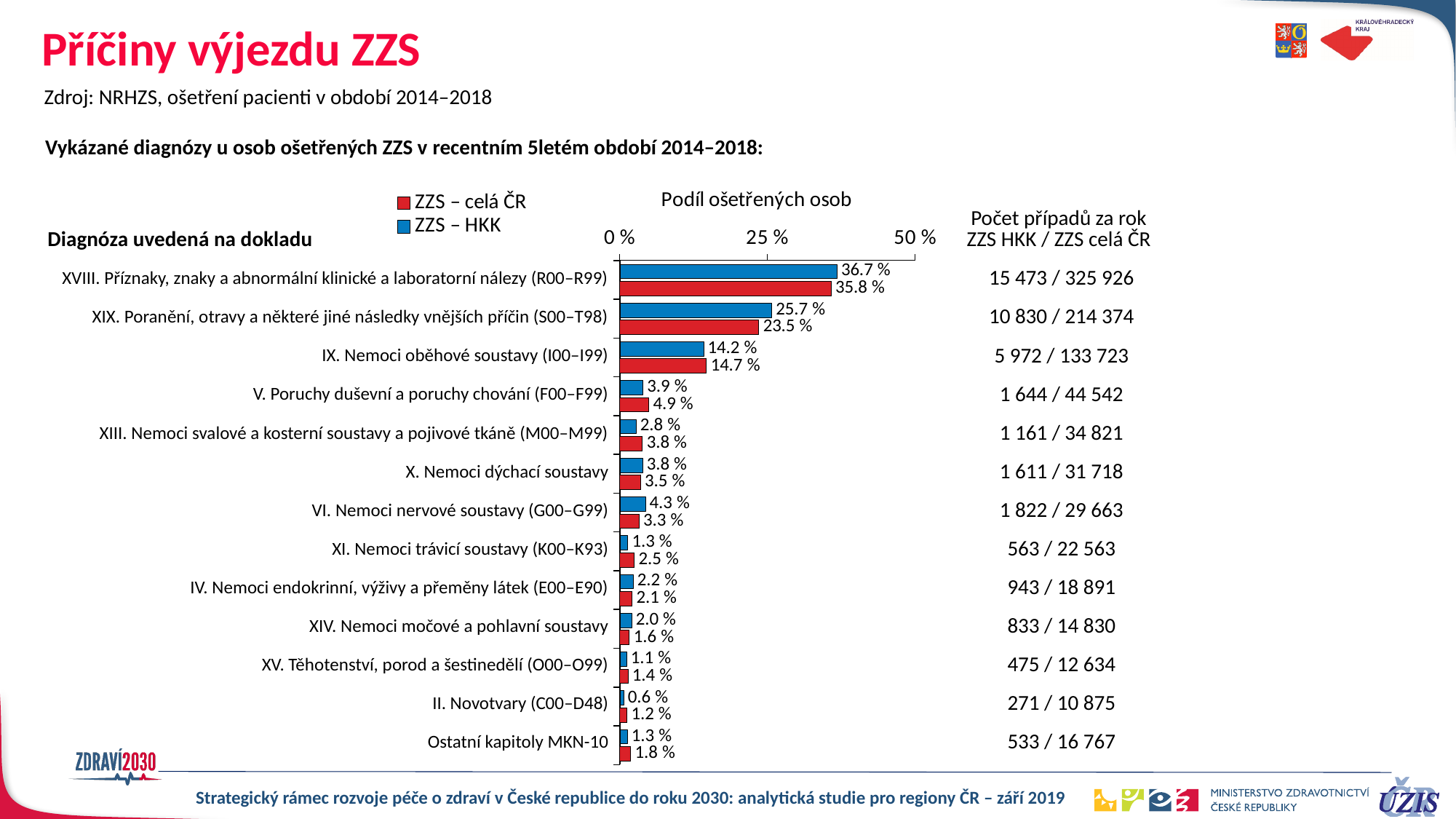
What kind of chart is shown on the slide? bar chart Which diagnosis category has the lowest ZZS – HKK share? II. Novotvary (C00–D48) Is the ZZS – HKK value for XIX. Poranění, otravy a některé jiné následky vnějších příčin (S00–T98) greater or less than 25 %? greater How many diagnosis categories are shown in the chart? 13 What is the ZZS – HKK value for VI. Nemoci nervové soustavy (G00–G99)? 4.3 % What is the ZZS – HKK value for XVIII. Příznaky, znaky a abnormální klinické a laboratorní nálezy (R00–R99)? 36.7 % Which colour represents the ZZS – HKK series in the chart? blue How many series does the legend list? 2 For V. Poruchy duševní a poruchy chování (F00–F99), which series has the larger value, ZZS – celá ČR or ZZS – HKK? ZZS – celá ČR Which diagnosis category has the highest ZZS – celá ČR share? XVIII. Příznaky, znaky a abnormální klinické a laboratorní nálezy (R00–R99) What is the difference between the ZZS – HKK and ZZS – celá ČR values for XIX. Poranění, otravy a některé jiné následky vnějších příčin (S00–T98)? 2.2 % What is the ZZS – celá ČR value for IX. Nemoci oběhové soustavy (I00–I99)? 14.7 %